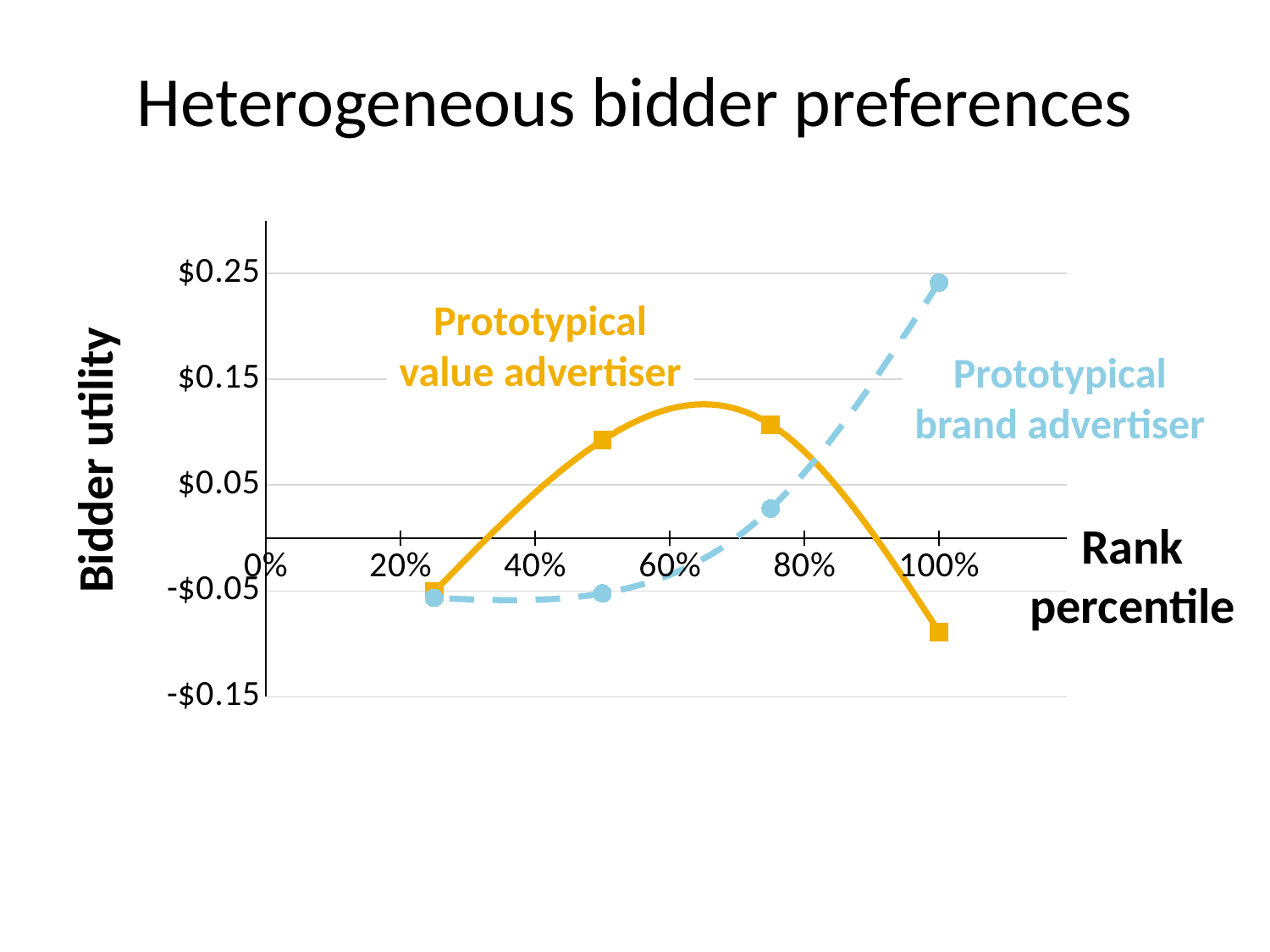
Is the value for the Prototypical value advertiser at 50% rank percentile greater or less than $0.05? greater Is the value for the Prototypical brand advertiser at 100% rank percentile greater or less than $0.15? greater At 50% rank percentile, which series has the higher bidder utility? Prototypical value advertiser What kind of chart is shown on the slide? line chart At 100% rank percentile, which series has the higher bidder utility? Prototypical brand advertiser Is the value for the Prototypical brand advertiser at 75% rank percentile greater or less than $0.05? less How many data points are plotted for the Prototypical brand advertiser series? 4 How many series are plotted on the chart? 2 At which rank percentile does the Prototypical brand advertiser reach its highest bidder utility? 100% Does the Prototypical brand advertiser's bidder utility rise or fall as rank percentile increases from 50% to 100%? rise At which rank percentile does the Prototypical value advertiser have its lowest bidder utility? 100%